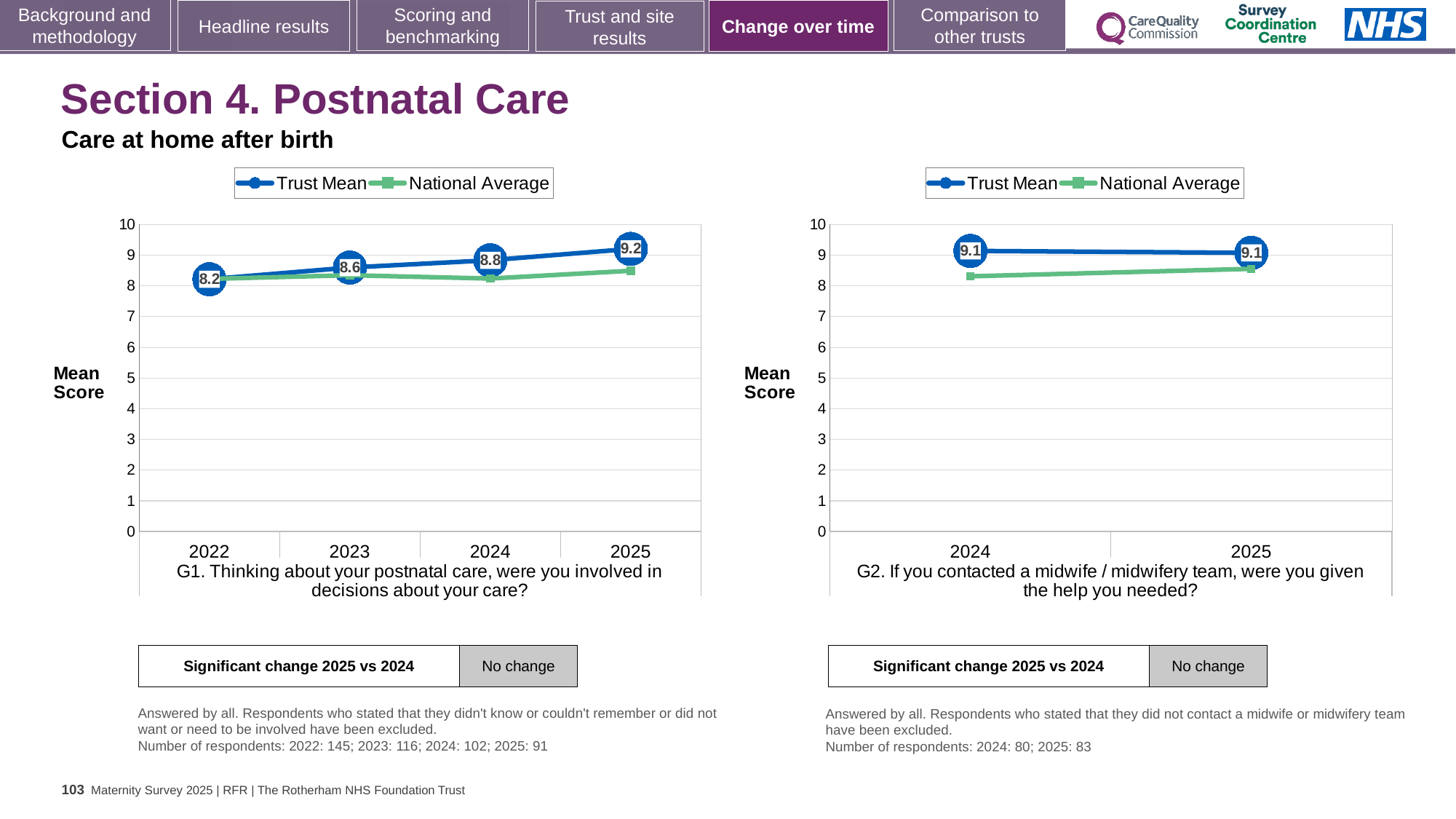
In the G1 chart on the left, what is the Trust Mean for 2025? 9.2 In the G1 chart on the left, what is the difference between the Trust Mean in 2025 and in 2022? 1.0 In the G1 chart on the left, is the National Average for 2025 greater or less than 9? less In the G1 chart on the left, which year has the lowest Trust Mean? 2022 In the G2 chart on the right, is the Trust Mean for 2025 larger than the National Average for 2025? Yes In the G2 chart on the right, what is the Trust Mean for 2024? 9.1 In the G1 chart on the left, how many years are plotted on the x axis? 4 What kind of chart is the G1 chart on the left? line chart How many series does the legend of the G2 chart on the right list? 2 In the G1 chart on the left, which year has the highest Trust Mean? 2025 In the G1 chart on the left, does the Trust Mean rise or fall from 2022 to 2025? rise In the G1 chart on the left, what is the Trust Mean for 2022? 8.2